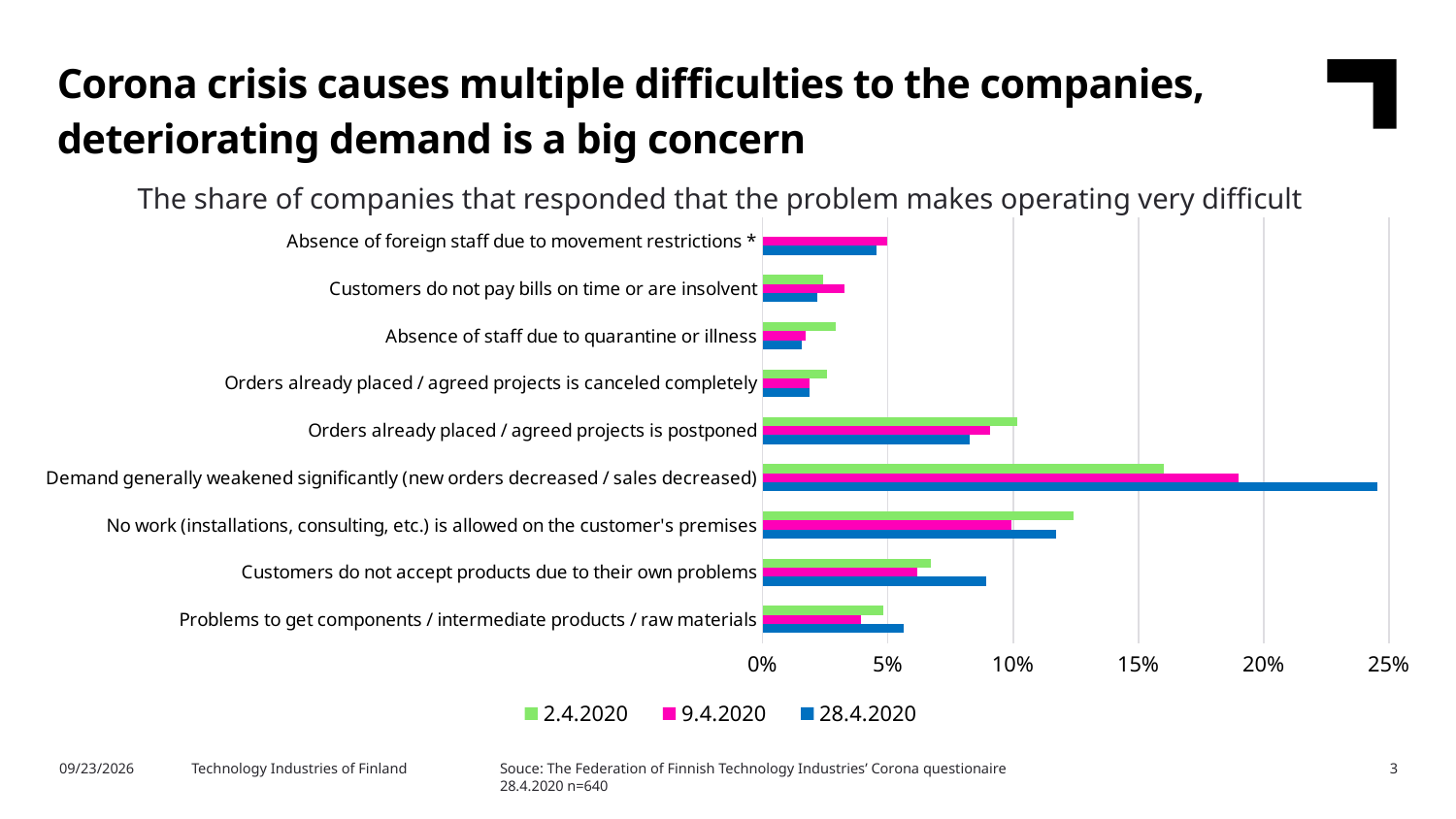
Is the 28.4.2020 value for 'Demand generally weakened significantly' greater or less than 20%? greater Which category has the highest value for the 28.4.2020 series? Demand generally weakened significantly (new orders decreased / sales decreased) How many problem categories are plotted in the chart? 9 Across the three survey dates, does the value for 'Demand generally weakened significantly' rise or fall? rise How many series does the chart legend list? 3 Is the 2.4.2020 value for 'Demand generally weakened significantly' greater or less than 10%? greater For 'Demand generally weakened significantly', which series has the larger value: 2.4.2020 or 28.4.2020? 28.4.2020 For 'Customers do not accept products due to their own problems', which series has the larger value: 9.4.2020 or 28.4.2020? 28.4.2020 What are the three entries in the chart legend? 2.4.2020, 9.4.2020, 28.4.2020 Is the 28.4.2020 value for 'Orders already placed / agreed projects is postponed' greater or less than 10%? less What kind of chart is shown on the slide? Bar chart